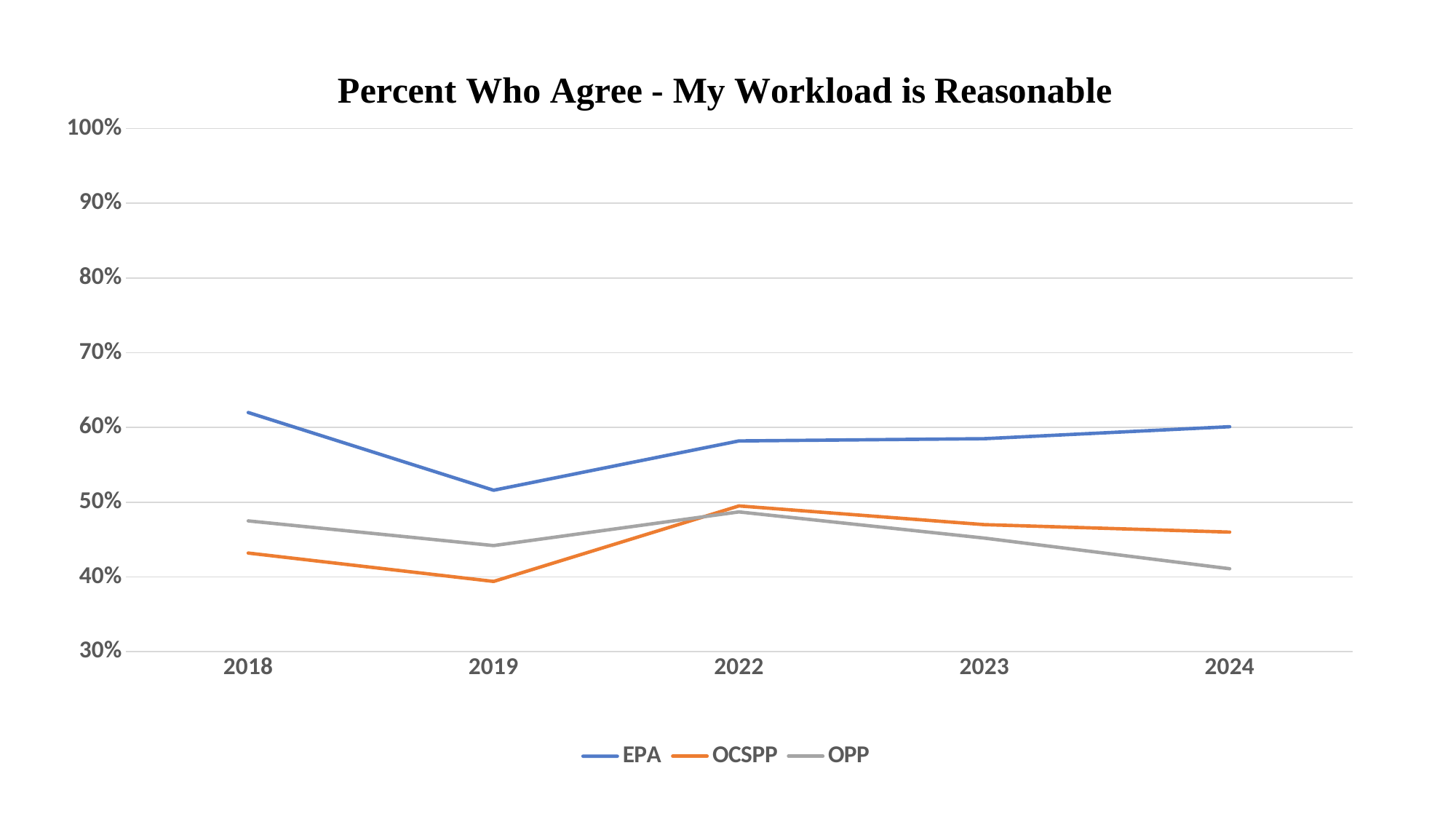
Is the EPA value for 2018 greater or less than 60%? greater What is the title of the chart? Percent Who Agree - My Workload is Reasonable In which year is the OPP value lowest? 2024 In which year is the OCSPP value highest? 2022 How many years are plotted along the x axis? 5 Is the OPP value for 2018 greater or less than 50%? less How many series does the legend list? 3 Which series has the highest values across all years? EPA Does the OPP line rise or fall from 2022 to 2024? Fall In which year is the EPA value lowest? 2019 In 2024, which is larger, the OCSPP value or the OPP value? OCSPP What kind of chart is shown on the slide? Line chart